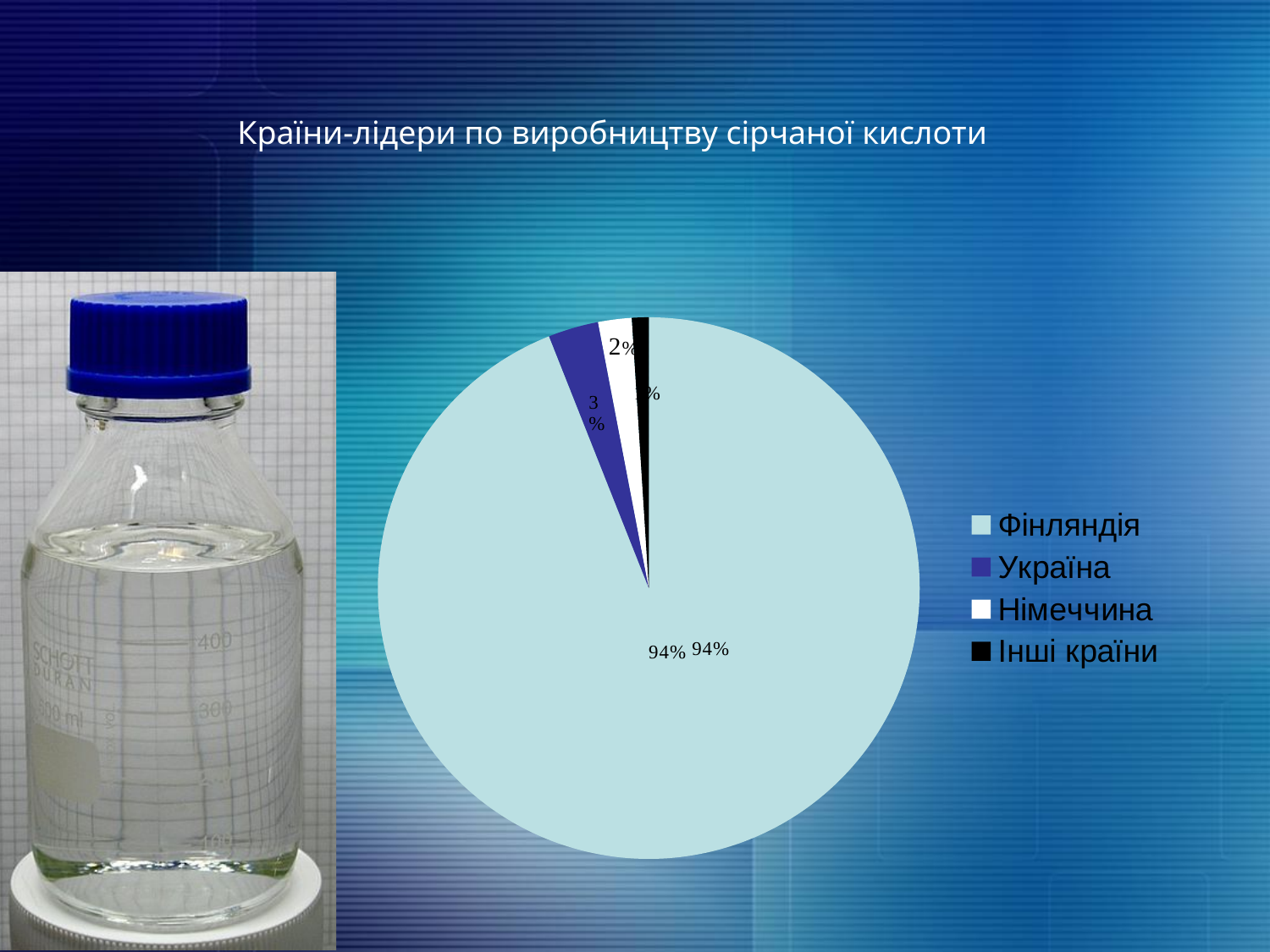
How many categories does the legend of the pie chart list? 4 What share of the pie does Україна have? 3% What share of the pie does Німеччина have? 2% By how many percentage points does the share of Фінляндія exceed the share of Україна? 91 Which legend entry is shown in black? Інші країни What kind of chart is shown on the slide? pie chart What is the title of the chart? Країни-лідери по виробництву сірчаної кислоти Which category has the smallest slice of the pie? Інші країни What share of the pie does Фінляндія have? 94% Which category has the largest slice of the pie? Фінляндія What colour is the slice for Фінляндія? light blue Which has a larger share, Україна or Німеччина? Україна